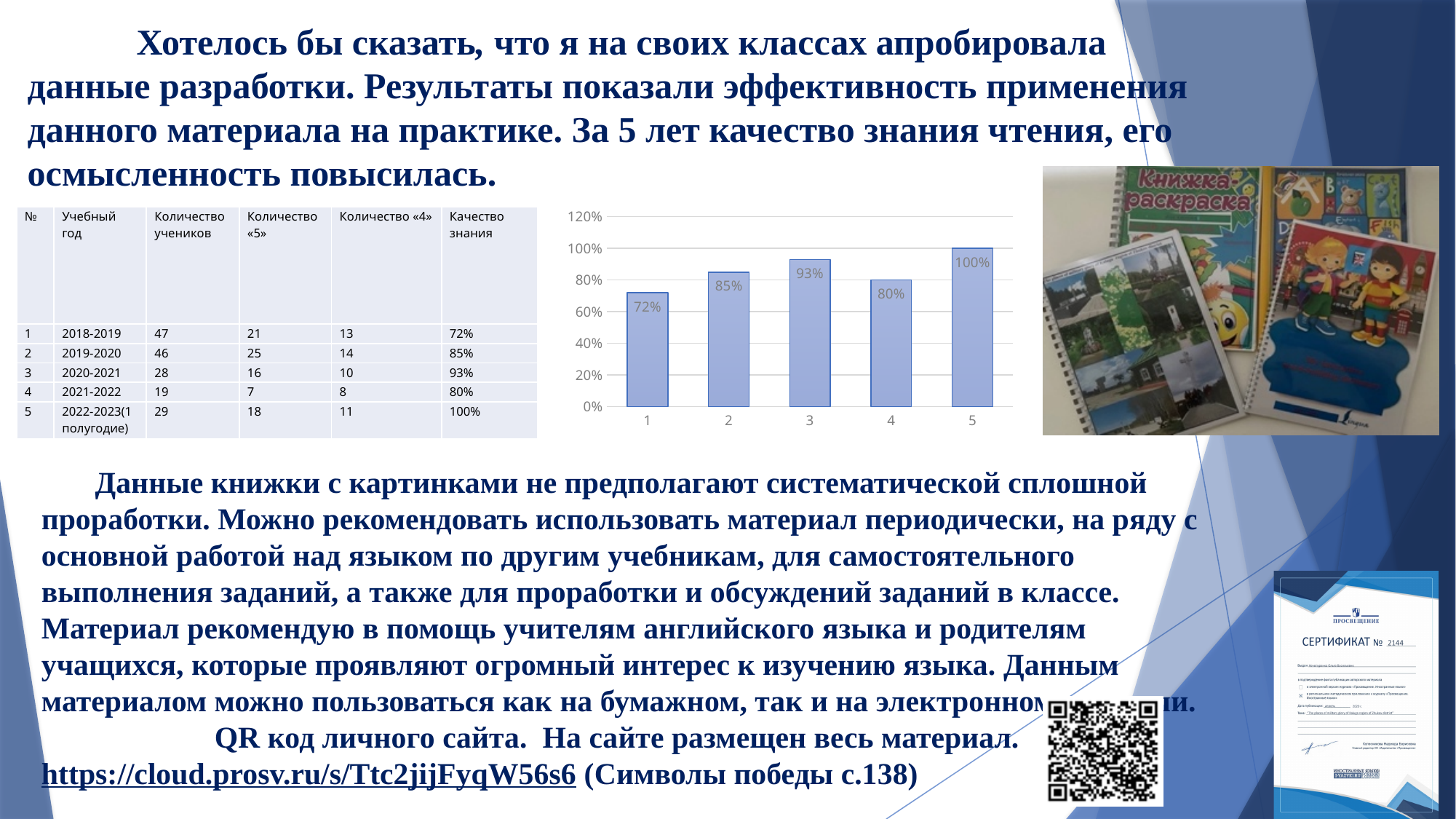
Which category has the lowest value in the chart? 1 Is the value for category 2 greater or less than 80%? greater How many bars are plotted in the chart? 5 Which is larger, the value for category 2 or the value for category 4? category 2 What is the value of the bar for category 4? 80% What is the value of the bar for category 3? 93% Which category has the highest value in the chart? 5 What is the value of the bar for category 1? 72% What type of chart is shown on the slide? bar chart What is the highest tick label shown on the vertical axis of the chart? 120% What is the difference between the values for category 5 and category 1? 28% What is the difference between the values for category 3 and category 4? 13%